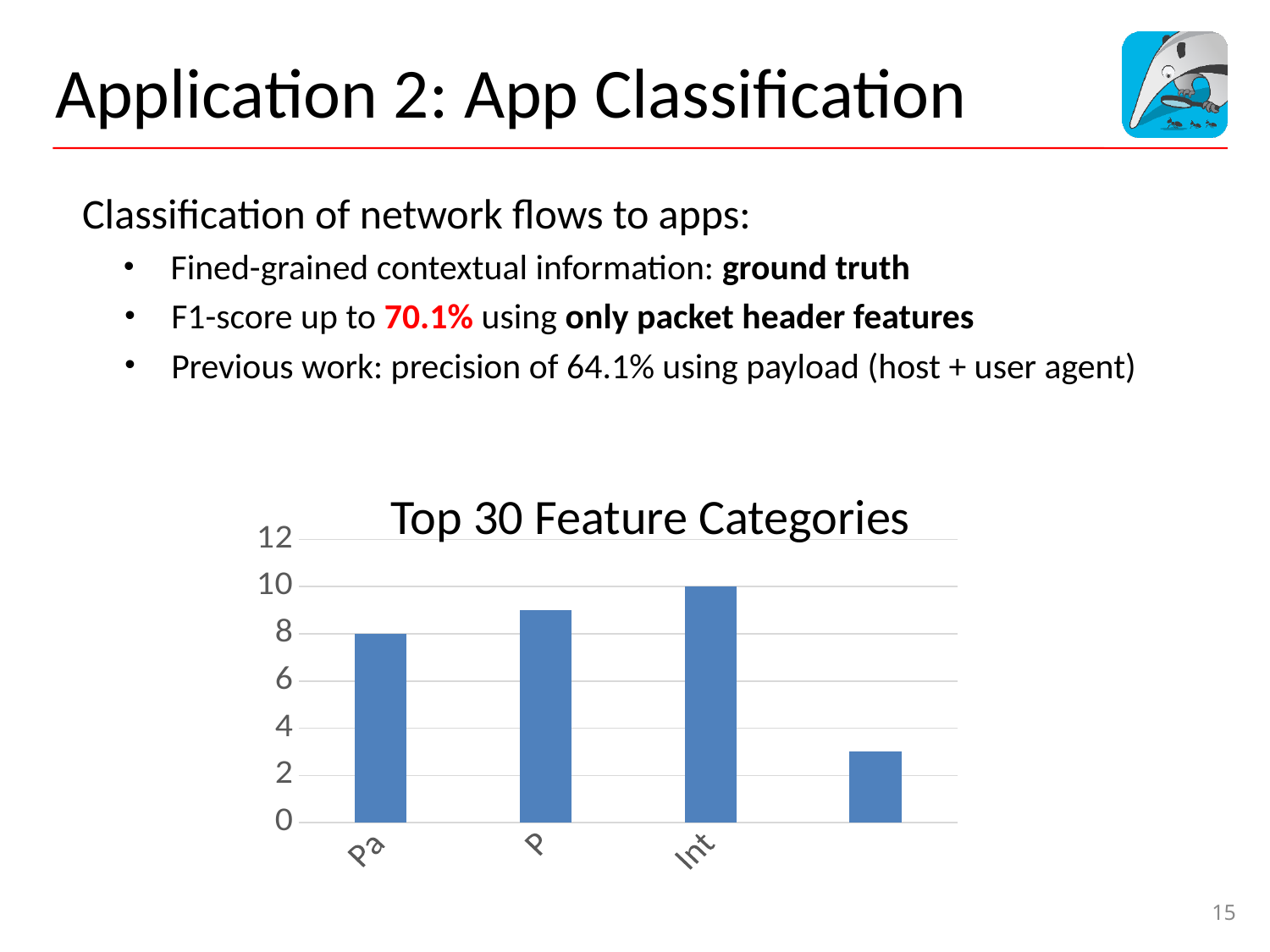
Which bar is the highest in the chart? the third bar (labelled "Int") Which is larger: the second bar ("P") or the fourth (rightmost) bar? the second bar ("P") What kind of chart is shown on the slide? bar chart What is the highest value shown on the y-axis? 12 Which bar is the lowest in the chart? the fourth (rightmost) bar What is the value of the first (leftmost) bar, labelled "Pa"? 8 What is the difference between the third bar ("Int") and the first bar ("Pa")? 2 How many bars does the chart show? 4 What is the value of the third bar, labelled "Int"? 10 Is the value of the fourth (rightmost) bar greater or less than 4? less Is the value of the second bar (labelled "P") greater or less than 8? greater What is the title of the chart? Top 30 Feature Categories